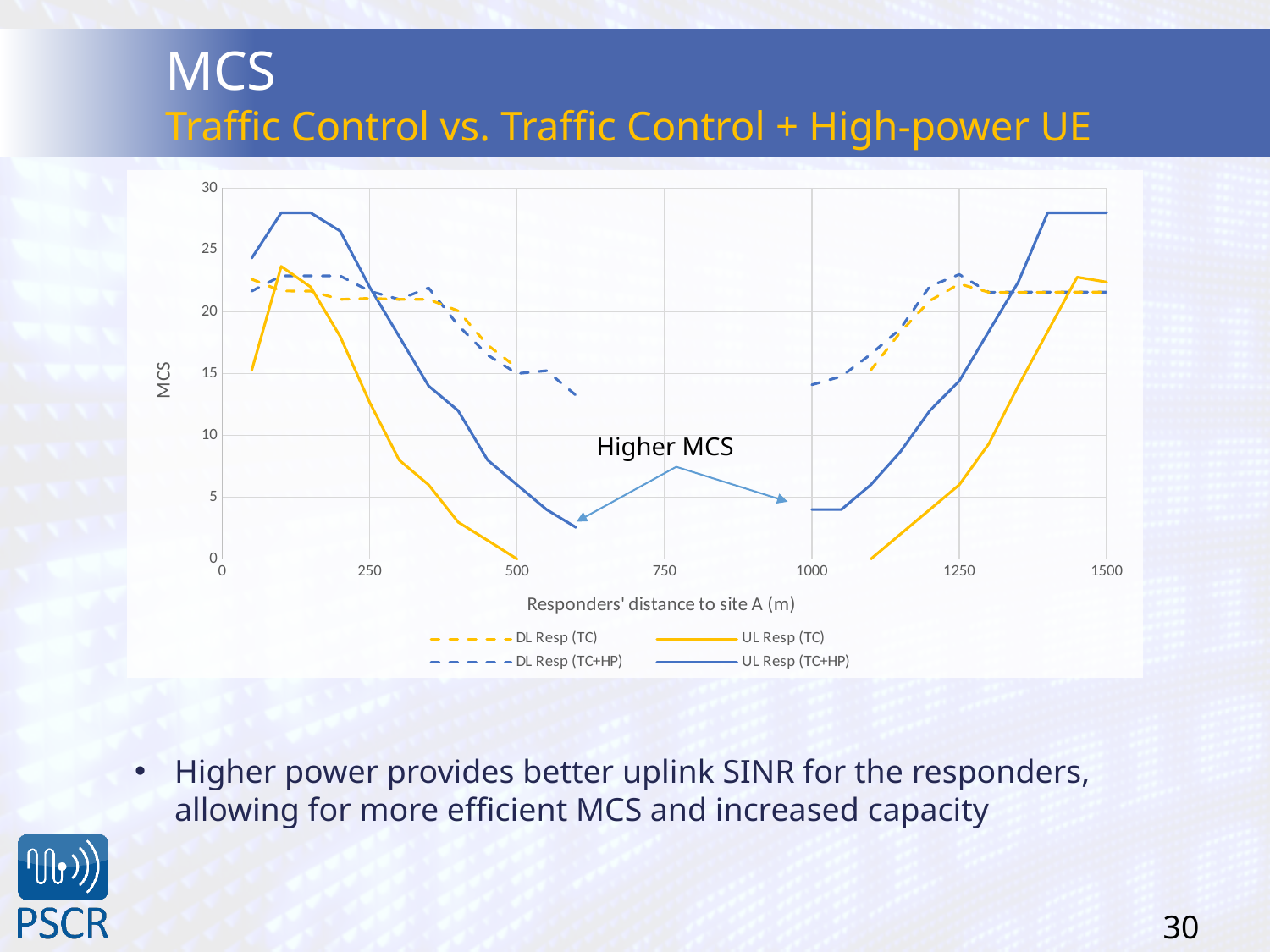
What is the title of the x axis? Responders' distance to site A (m) At 400 m, which series has the higher MCS: UL Resp (TC) or UL Resp (TC+HP)? UL Resp (TC+HP) Is the value for DL Resp (TC+HP) at 600 m greater or less than 15? less Is the value for UL Resp (TC+HP) at 100 m greater or less than 25? greater Does the UL Resp (TC) series rise or fall between 100 m and 500 m? fall What is the label on the y axis? MCS How many series does the legend list? 4 Is the value for UL Resp (TC+HP) at 1500 m greater or less than 25? greater Does the UL Resp (TC+HP) series rise or fall between 1000 m and 1400 m? rise At 1500 m, which series has the higher MCS: UL Resp (TC) or UL Resp (TC+HP)? UL Resp (TC+HP) What kind of chart is shown on the slide? line chart